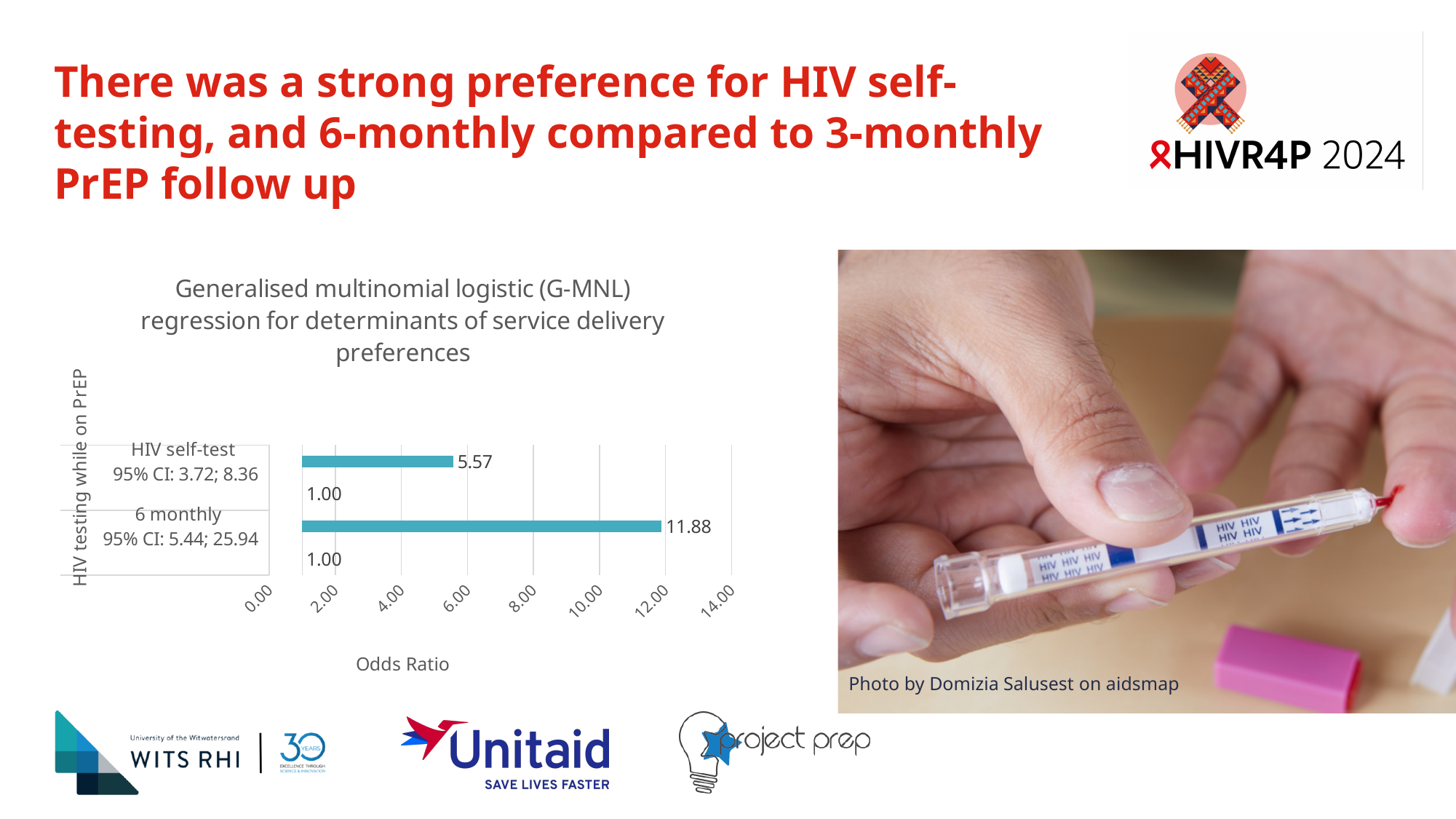
What is the 95% confidence interval shown for HIV self-test? 3.72; 8.36 What is the odds ratio shown for 6 monthly? 11.88 What type of chart is shown on the slide? Bar chart Which category has the highest odds ratio in the chart? 6 monthly What value is shown for the reference bars in the chart? 1.00 What is the 95% confidence interval shown for 6 monthly? 5.44; 25.94 What is the difference between the odds ratios for 6 monthly and HIV self-test? 6.31 Which category has the higher odds ratio, HIV self-test or 6 monthly? 6 monthly What is the label of the horizontal axis of the chart? Odds Ratio Is the odds ratio for 6 monthly greater or less than 10.00? greater What is the odds ratio shown for HIV self-test? 5.57 Is the odds ratio for HIV self-test greater or less than 6.00? less